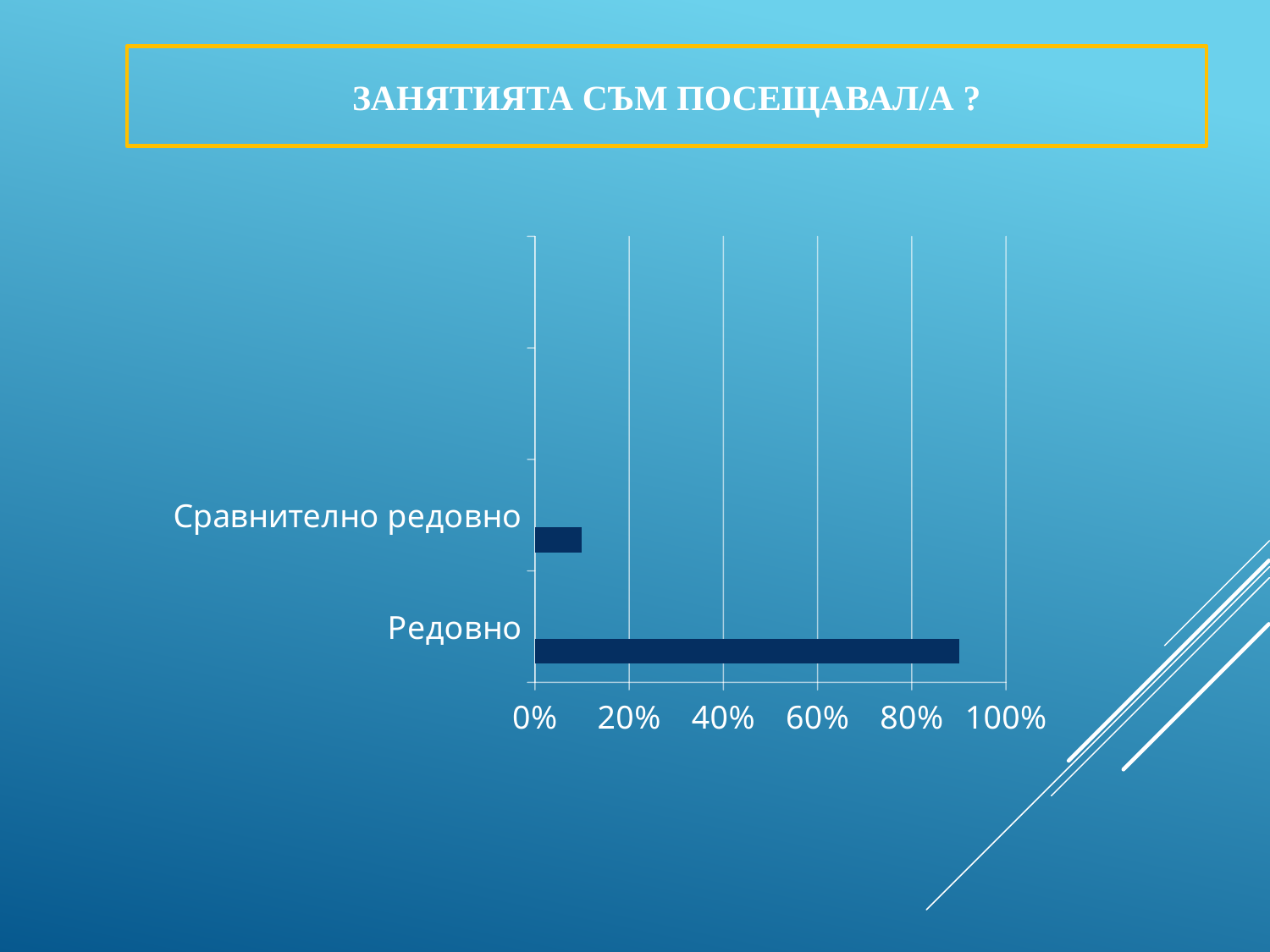
Is the value for Сравнително редовно greater or less than 20%? less How many categories are plotted in the bar chart? 2 What is the highest value shown on the x axis of the bar chart? 100% Is the value for Редовно greater or less than 100%? less Is the value for Сравнително редовно greater or less than 40%? less Which is larger, the value for Редовно or the value for Сравнително редовно? Редовно Which category has the lowest value in the bar chart? Сравнително редовно What is the title text shown above the chart on the slide? ЗАНЯТИЯТА СЪМ ПОСЕЩАВАЛ/А ? Which category has the highest value in the bar chart? Редовно What kind of chart is shown on the slide? bar chart